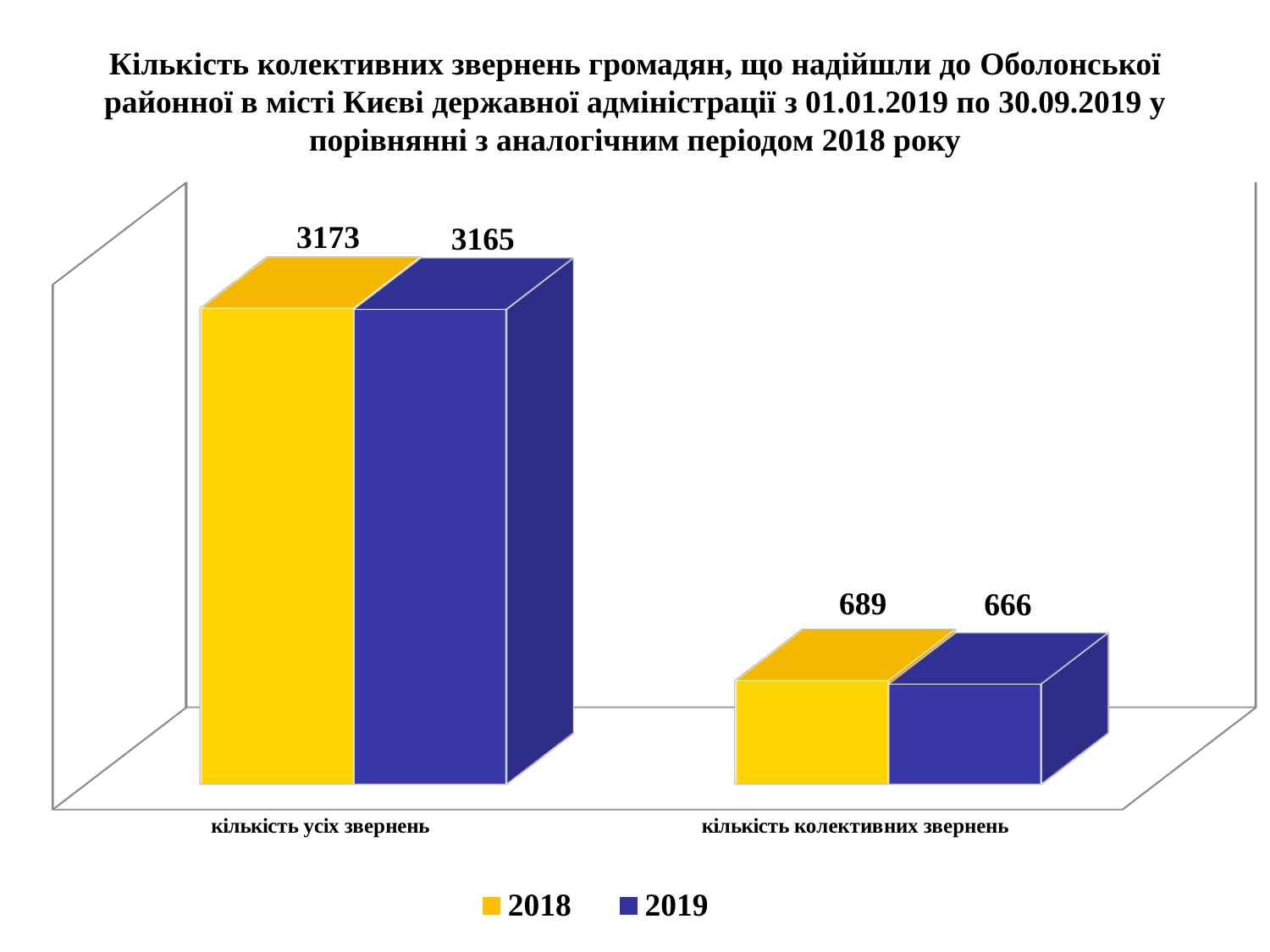
What is the value for 2018 in the category "кількість усіх звернень"? 3173 Which category has the highest value for the 2018 series? кількість усіх звернень What is the difference between the 2018 and 2019 values for "кількість усіх звернень"? 8 What is the value for 2019 in the category "кількість усіх звернень"? 3165 What is the value for 2019 in the category "кількість колективних звернень"? 666 Which category has the lowest value for the 2019 series? кількість колективних звернень How many series does the legend list? 2 What is the difference between the 2018 and 2019 values for "кількість колективних звернень"? 23 What kind of chart is shown on the slide? bar chart Which is larger: the 2018 value or the 2019 value for "кількість колективних звернень"? 2018 How many categories are shown on the x axis? 2 What is the value for 2018 in the category "кількість колективних звернень"? 689